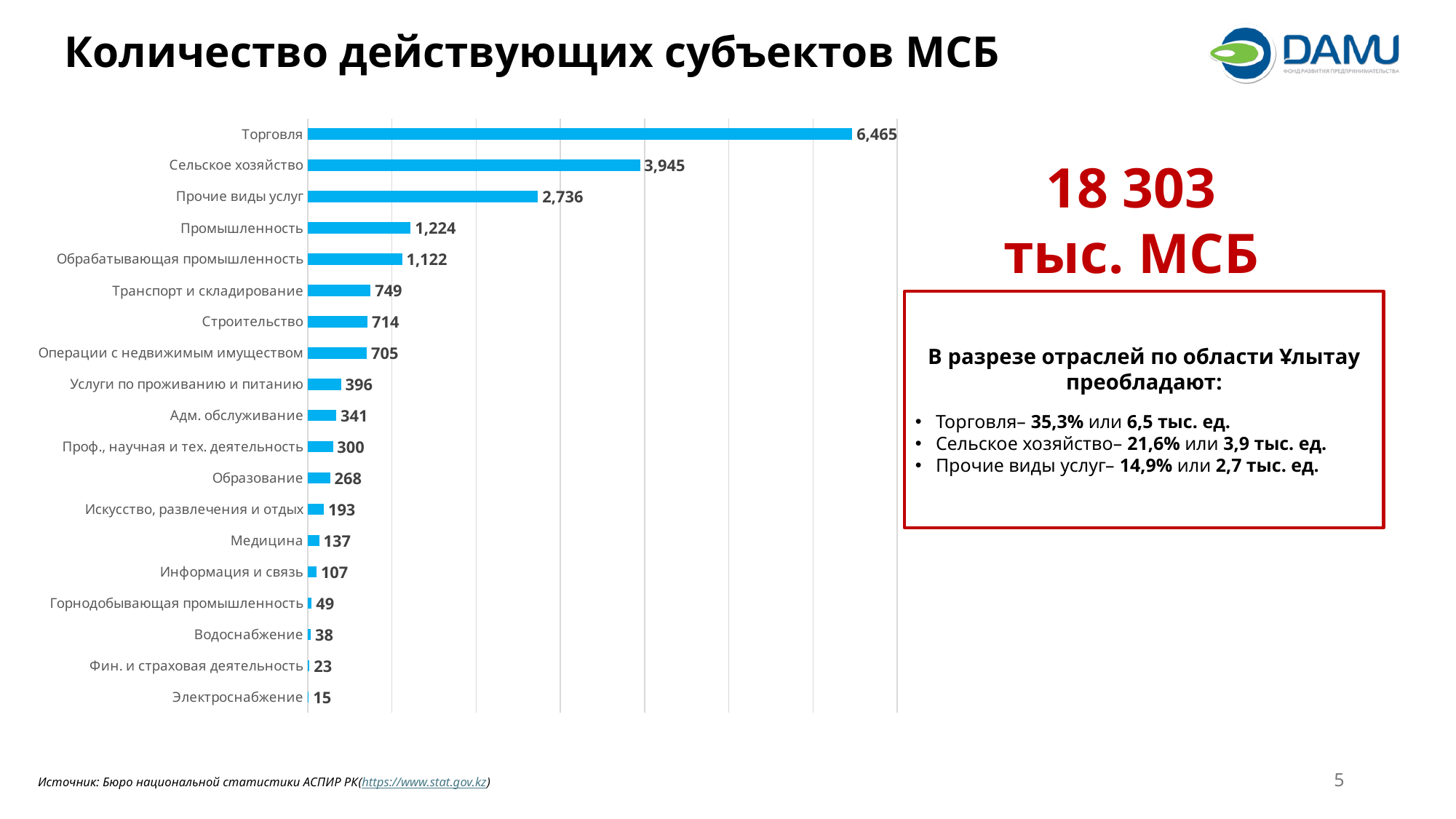
Which category has the lowest value? Электроснабжение How many categories are shown in the chart? 19 Which category has the highest value? Торговля What is the value for Транспорт и складирование? 749 What is the value for Медицина? 137 What is the title of the slide containing the chart? Количество действующих субъектов МСБ What is the value for Торговля? 6,465 What is the value for Сельское хозяйство? 3,945 What is the difference between the values for Промышленность and Обрабатывающая промышленность? 102 What is the difference between the values for Торговля and Сельское хозяйство? 2,520 What kind of chart is shown on the slide? Bar chart Which is larger, the value for Строительство or the value for Услуги по проживанию и питанию? Строительство